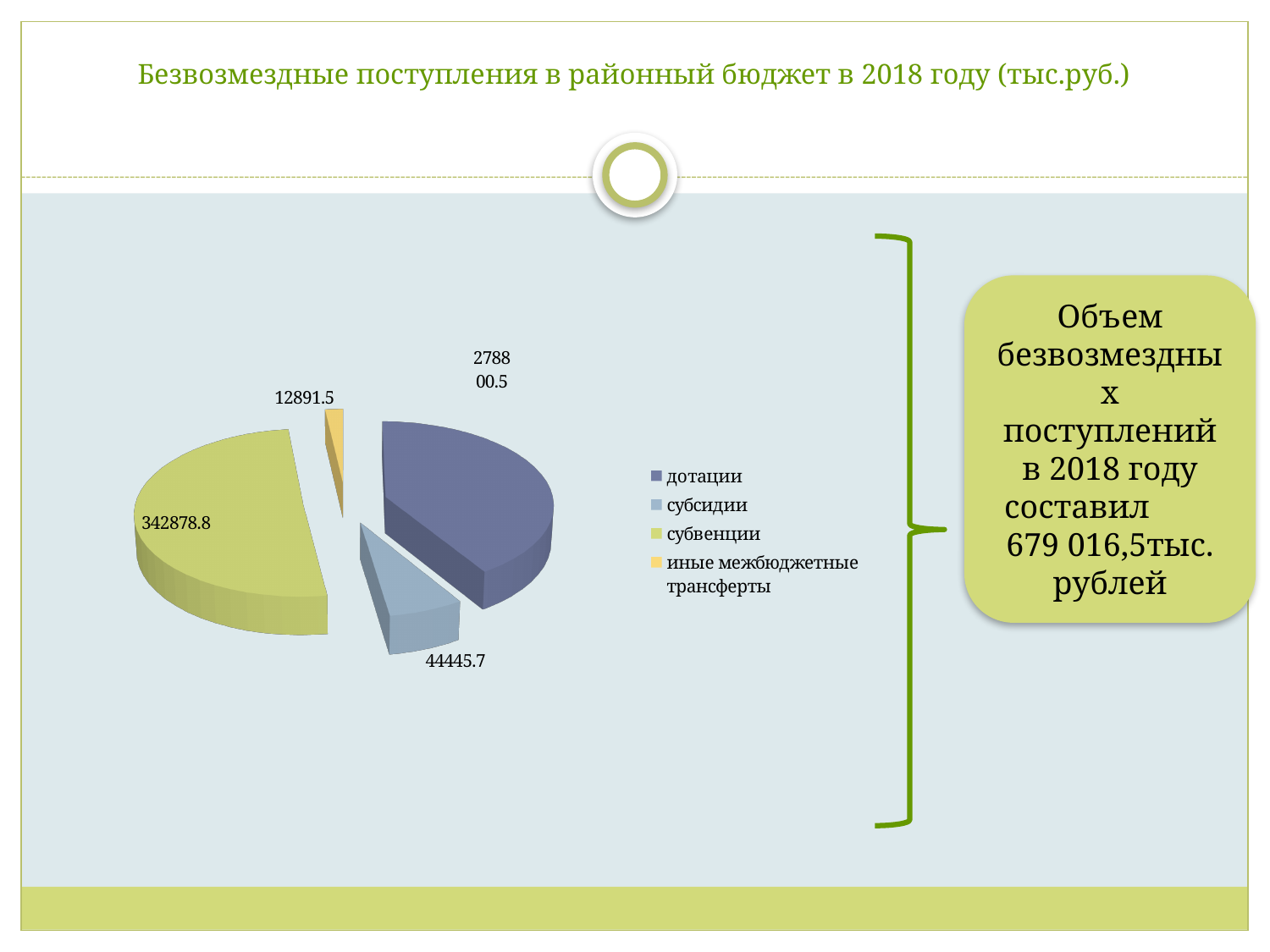
Which category has the largest slice in the pie chart? субвенции What is the value for иные межбюджетные трансферты in the pie chart? 12891.5 What is the difference between the values for субсидии and иные межбюджетные трансферты? 31554.2 How many slices does the pie chart have? 4 Which category has the smallest slice in the pie chart? иные межбюджетные трансферты What is the difference between the values for субвенции and дотации? 64078.3 What is the value for субсидии in the pie chart? 44445.7 What is the value for субвенции in the pie chart? 342878.8 Which is larger, дотации or субсидии? дотации Which legend entry is shown in yellow in the pie chart? иные межбюджетные трансферты What is the value for дотации in the pie chart? 278800.5 What type of chart is shown on the slide? pie chart